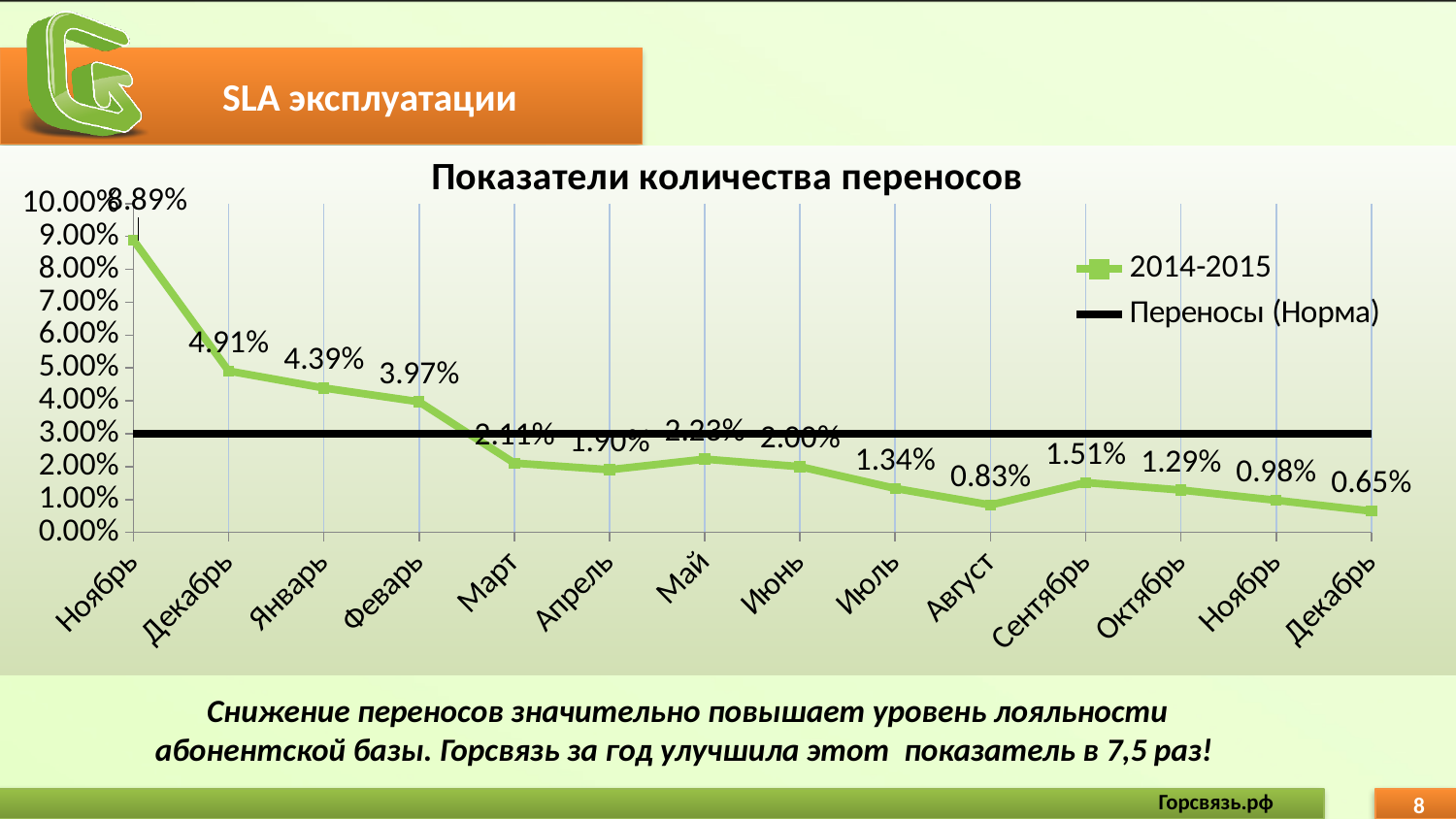
What is the value for Август on the 2014-2015 line? 0.83% What is the difference between the values for Февраль and Март on the 2014-2015 line? 1.86% How many series does the chart legend list? 2 How many data points are plotted on the 2014-2015 line? 14 Do the values on the 2014-2015 line generally rise or fall from left to right along the x axis? fall Is the value for Март on the 2014-2015 line greater or less than 3.00%? less What type of chart is shown on the slide? Line chart What is the value for Февраль on the 2014-2015 line? 3.97% What is the title of the chart? Показатели количества переносов Which month has the lowest value on the 2014-2015 line? Декабрь (the last month on the axis), 0.65% What is the value for Сентябрь on the 2014-2015 line? 1.51% Which is larger on the 2014-2015 line, the value for Май or the value for Июнь? Май